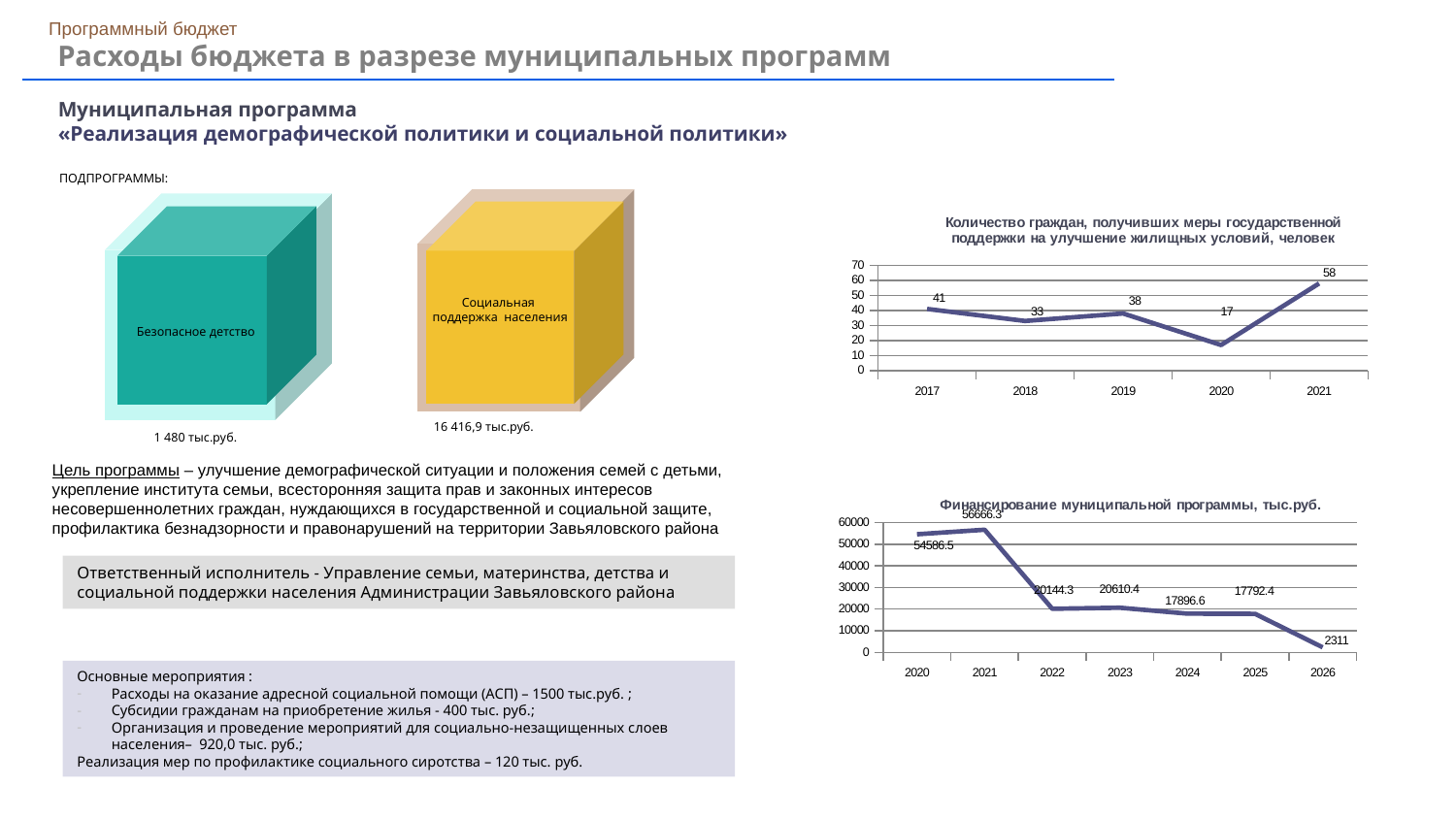
In the chart 'Финансирование муниципальной программы, тыс.руб.', what is the value for 2023? 20610.4 In the chart 'Финансирование муниципальной программы, тыс.руб.', which is larger, the value for 2022 or the value for 2024? 2022 In the chart 'Количество граждан, получивших меры государственной поддержки на улучшение жилищных условий, человек', what is the value for 2019? 38 In the chart 'Финансирование муниципальной программы, тыс.руб.', how many years are plotted? 7 What type of chart is 'Количество граждан, получивших меры государственной поддержки на улучшение жилищных условий, человек'? line chart In the chart 'Финансирование муниципальной программы, тыс.руб.', what is the value for 2026? 2311 In the chart 'Количество граждан, получивших меры государственной поддержки на улучшение жилищных условий, человек', which year has the highest value? 2021 In the chart 'Количество граждан, получивших меры государственной поддержки на улучшение жилищных условий, человек', what is the difference between the values for 2021 and 2020? 41 In the chart 'Финансирование муниципальной программы, тыс.руб.', which year has the highest value? 2021 In the chart 'Количество граждан, получивших меры государственной поддержки на улучшение жилищных условий, человек', how many years are plotted? 5 In the chart 'Финансирование муниципальной программы, тыс.руб.', do the values generally rise or fall from 2021 to 2026? fall In the chart 'Количество граждан, получивших меры государственной поддержки на улучшение жилищных условий, человек', which year has the lowest value? 2020